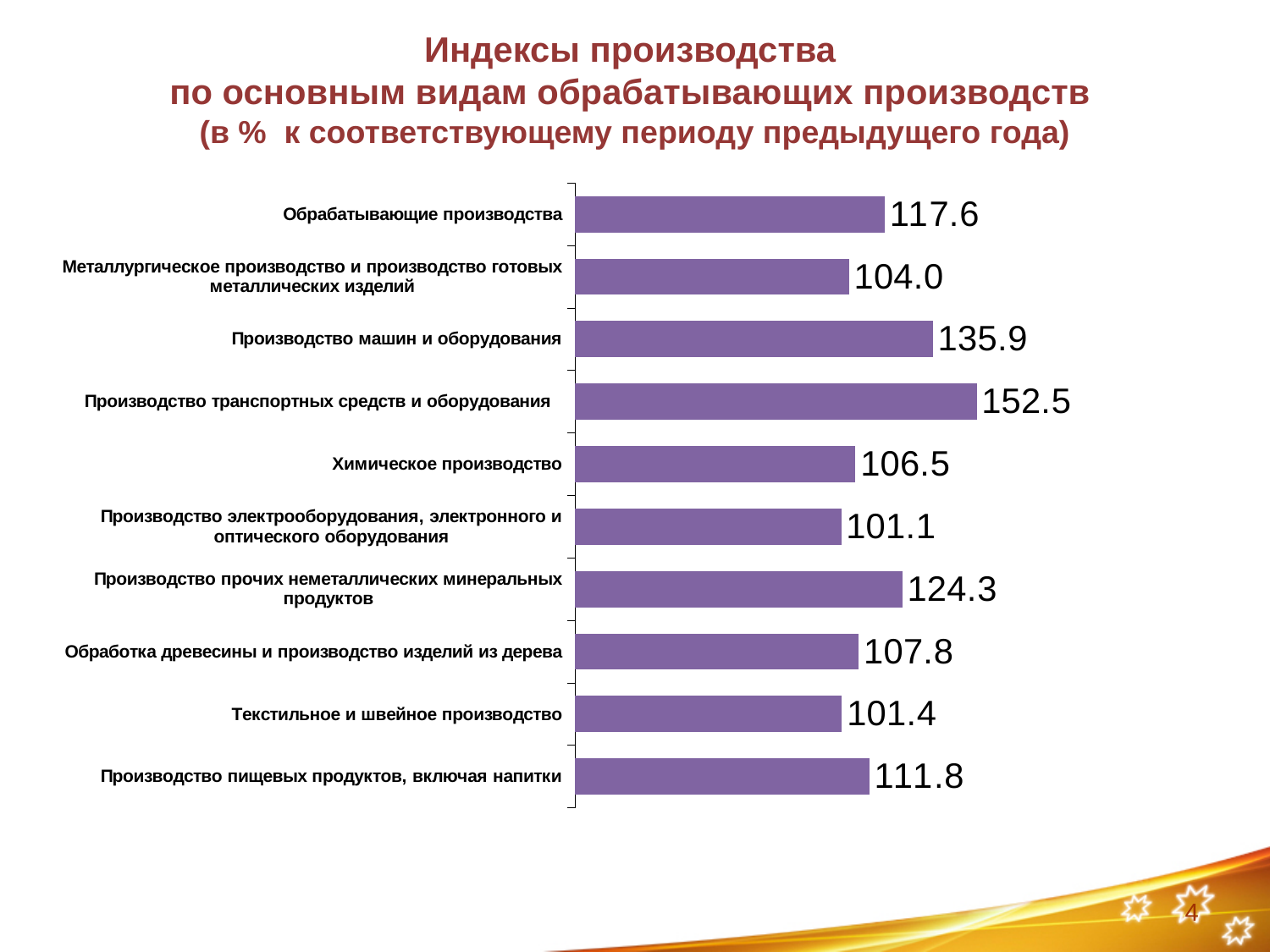
How many categories are shown in the chart? 10 What is the value for Производство транспортных средств и оборудования? 152.5 What kind of chart is shown on the slide? Bar chart What is the value for Обрабатывающие производства? 117.6 Which category has the highest value? Производство транспортных средств и оборудования What is the difference between the values for Обрабатывающие производства and Текстильное и швейное производство? 16.2 Which is larger: the value for Производство прочих неметаллических минеральных продуктов or the value for Обработка древесины и производство изделий из дерева? Производство прочих неметаллических минеральных продуктов What is the value for Производство пищевых продуктов, включая напитки? 111.8 What colour are the bars in the chart? Purple What is the difference between the values for Производство машин и оборудования and Металлургическое производство и производство готовых металлических изделий? 31.9 Which category has the lowest value? Производство электрооборудования, электронного и оптического оборудования What is the value for Химическое производство? 106.5